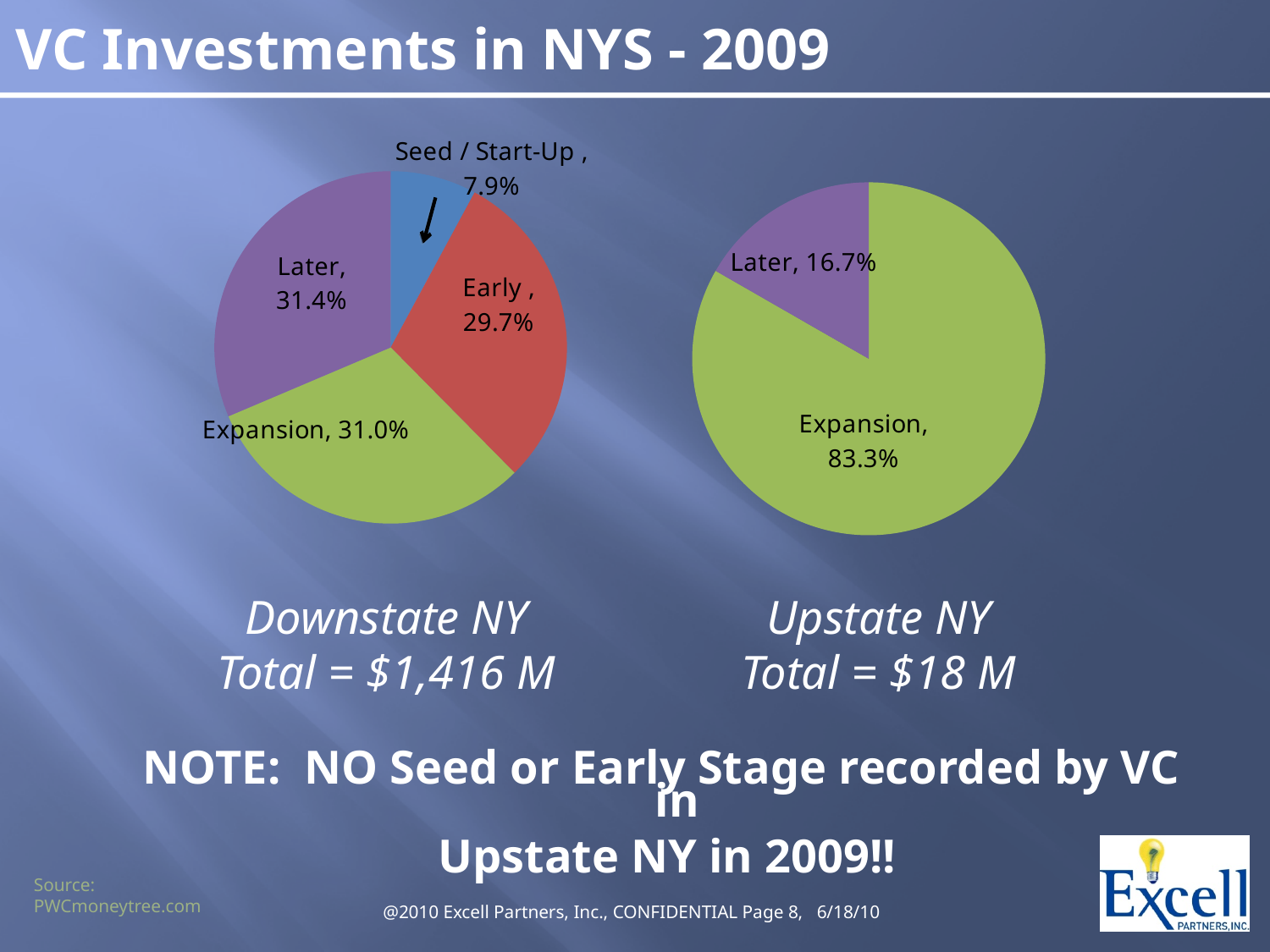
What kind of chart is used for the Upstate NY data? Pie chart In the Downstate NY pie chart, what share does Seed / Start-Up have? 7.9% In the Downstate NY pie chart, which is larger, Expansion or Early? Expansion How many slices does the Upstate NY pie chart have? 2 In the Downstate NY pie chart, which category has the largest share? Later How many slices does the Downstate NY pie chart have? 4 In the Upstate NY pie chart, what share does Later have? 16.7% In the Upstate NY pie chart, what share does Expansion have? 83.3% In the Downstate NY pie chart, what share does Early have? 29.7% In the Upstate NY pie chart, what is the difference between the Expansion share and the Later share? 66.6% In the Downstate NY pie chart, what is the difference between the Later share and the Early share? 1.7% In the Downstate NY pie chart, which category has the smallest share? Seed / Start-Up